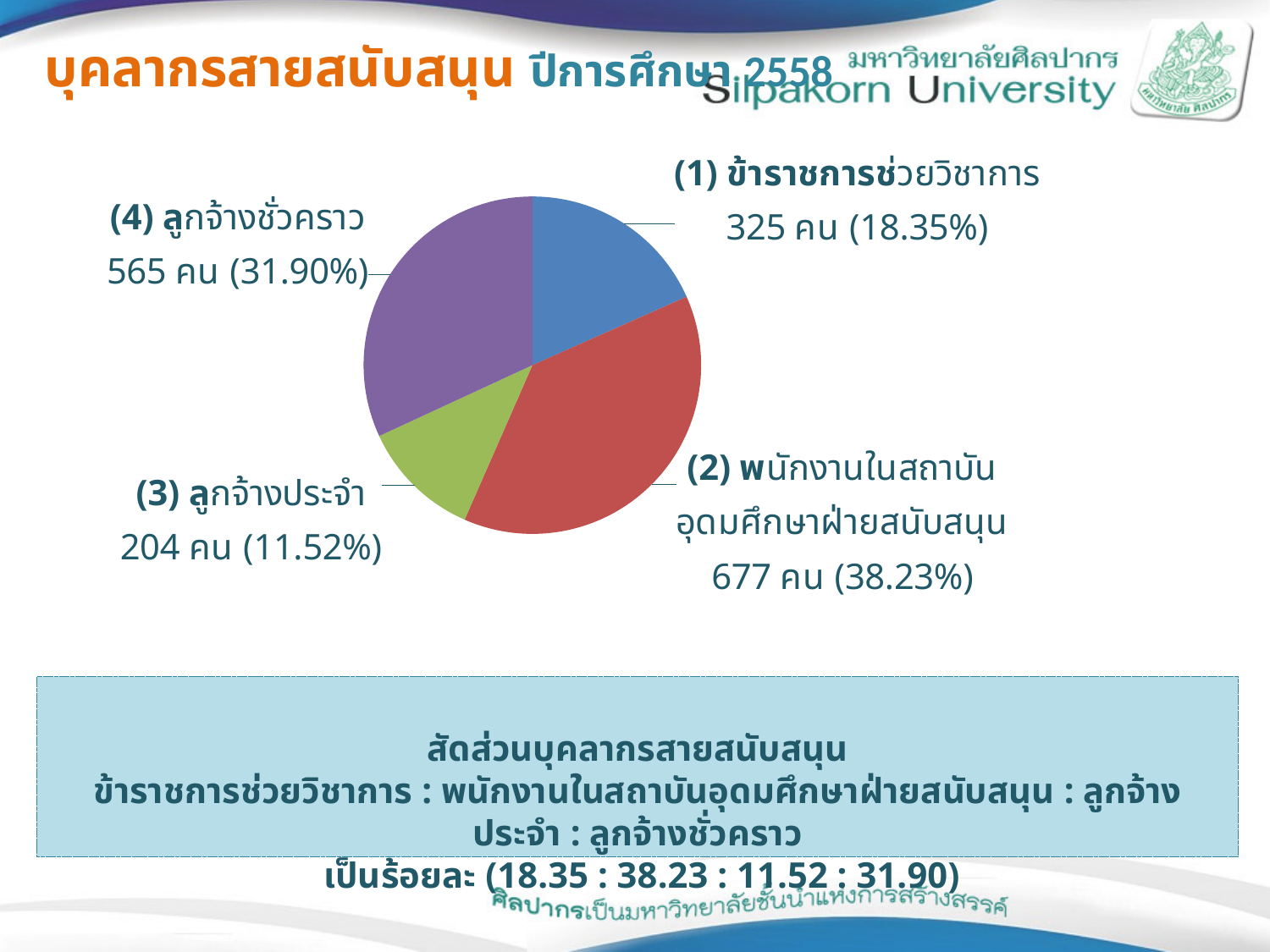
How many slices does the pie chart have? 4 What percentage share does the พนักงานในสถาบันอุดมศึกษาฝ่ายสนับสนุน slice have? 38.23% Which category has the largest slice of the pie? พนักงานในสถาบันอุดมศึกษาฝ่ายสนับสนุน What is the total number of people across all four slices of the pie? 1771 คน Which category has the smallest slice of the pie? ลูกจ้างประจำ Which has more people, ข้าราชการช่วยวิชาการ or ลูกจ้างชั่วคราว? ลูกจ้างชั่วคราว How many people are in the ข้าราชการช่วยวิชาการ category? 325 คน How many people are in the ลูกจ้างประจำ category? 204 คน What colour is the slice for พนักงานในสถาบันอุดมศึกษาฝ่ายสนับสนุน? red What percentage share does the ลูกจ้างชั่วคราว slice have? 31.90% What is the difference in headcount between ลูกจ้างชั่วคราว and ลูกจ้างประจำ? 361 คน What kind of chart is shown on the slide? pie chart